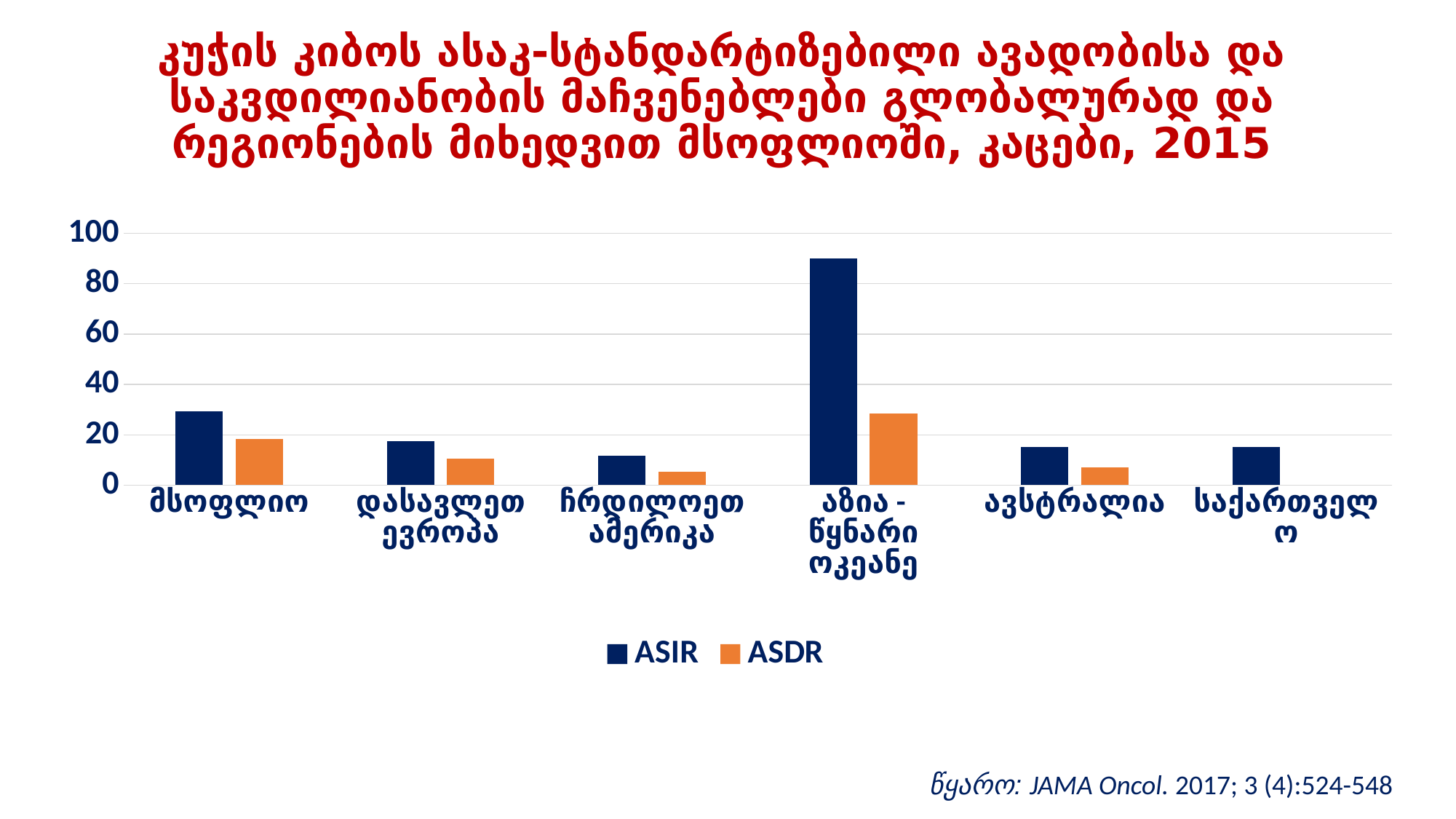
How many categories are shown on the x axis of the chart? 6 Is the ASIR value for მსოფლიო greater or less than 40? less Which is larger for მსოფლიო, the ASIR value or the ASDR value? ASIR Which category has the highest ASDR value? აზია - წყნარი ოკეანე What colour are the ASDR bars in the chart? orange How many series does the legend list? 2 Which category has a larger ASIR value, მსოფლიო or დასავლეთ ევროპა? მსოფლიო Which category has the highest ASIR value? აზია - წყნარი ოკეანე Is the ASIR value for აზია - წყნარი ოკეანე greater or less than 80? greater What are the two series named in the legend? ASIR and ASDR Is the ASDR value for ჩრდილოეთ ამერიკა greater or less than 20? less What kind of chart is shown on the slide? bar chart